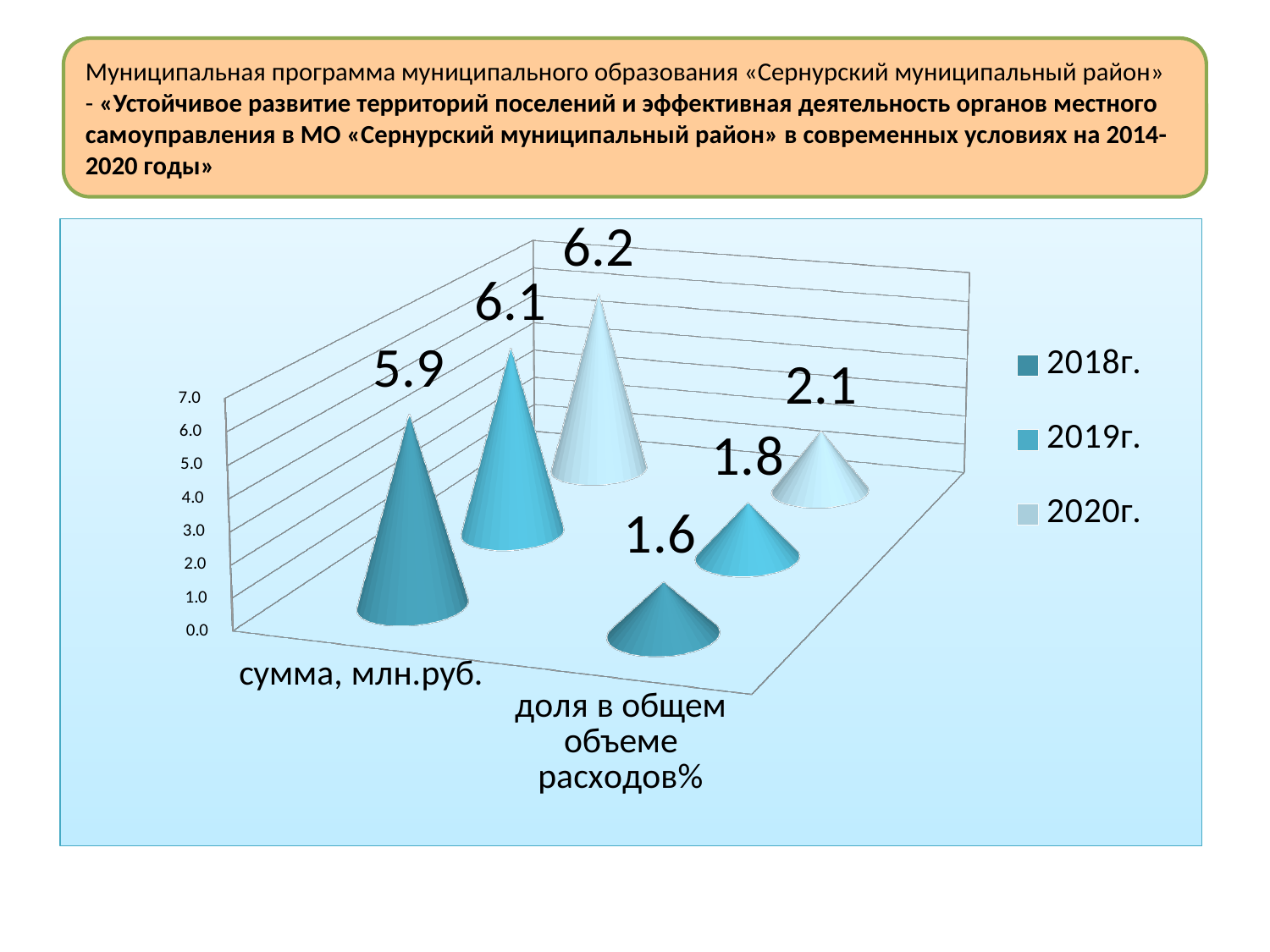
What is the difference between the 2020г. and 2019г. values in the category «доля в общем объеме расходов%»? 0.3 What is the value for 2020г. in the category «доля в общем объеме расходов%»? 2.1 Which year has the highest value in the category «сумма, млн.руб.»? 2020г. Which is larger: the 2019г. value for «сумма, млн.руб.» or the 2019г. value for «доля в общем объеме расходов%»? сумма, млн.руб. What is the value for 2018г. in the category «сумма, млн.руб.»? 5.9 What is the value for 2020г. in the category «сумма, млн.руб.»? 6.2 What is the difference between the 2020г. and 2018г. values in the category «сумма, млн.руб.»? 0.3 What is the value for 2019г. in the category «доля в общем объеме расходов%»? 1.8 How many series does the legend list? 3 Do the values for «сумма, млн.руб.» rise or fall from 2018г. to 2020г.? rise How many categories are shown on the x axis of the chart? 2 Which year has the lowest value in the category «доля в общем объеме расходов%»? 2018г.